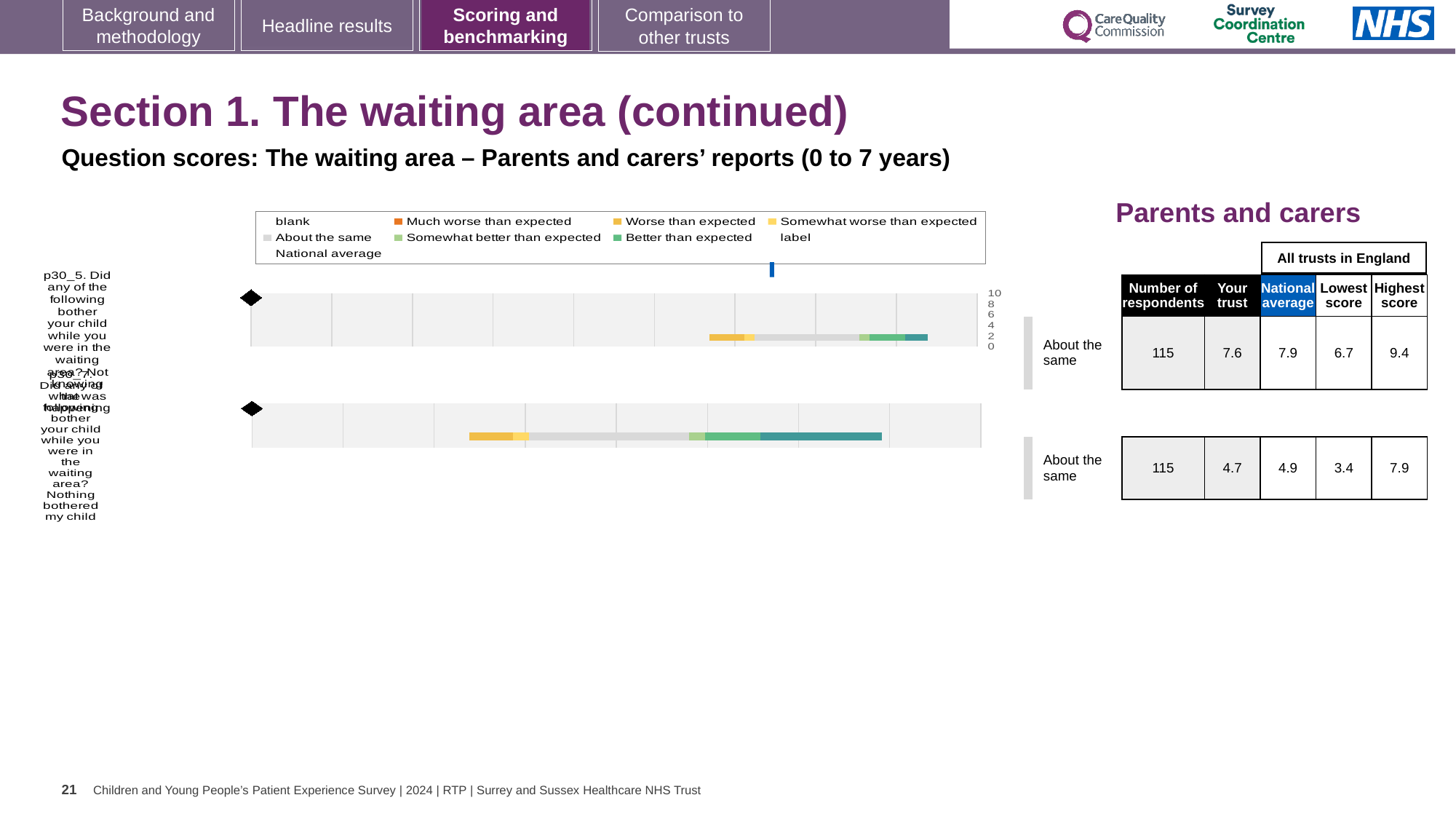
According to the table beside the chart, what is the lowest score among all trusts in England for question p30_7? 3.4 What colour is the 'Better than expected' band in the legend? teal green What kind of chart is shown on the slide? bar chart What is the highest value shown on the chart's axis? 10 For question p30_5, which is larger: the 'Your trust' score or the national average? National average How many question bars are plotted in the chart? 2 According to the table beside the chart, what is the national average for question p30_7 (Nothing bothered my child)? 4.9 For question p30_5, what is the difference between the national average (7.9) and the 'Your trust' score (7.6)? 0.3 For question p30_7, what is the difference between the highest score (7.9) and the lowest score (3.4)? 4.5 According to the table beside the chart, what is the 'Your trust' score for question p30_5 (Not knowing what was happening)? 7.6 How many entries does the chart legend list? 9 According to the table beside the chart, what is the highest score among all trusts in England for question p30_5? 9.4